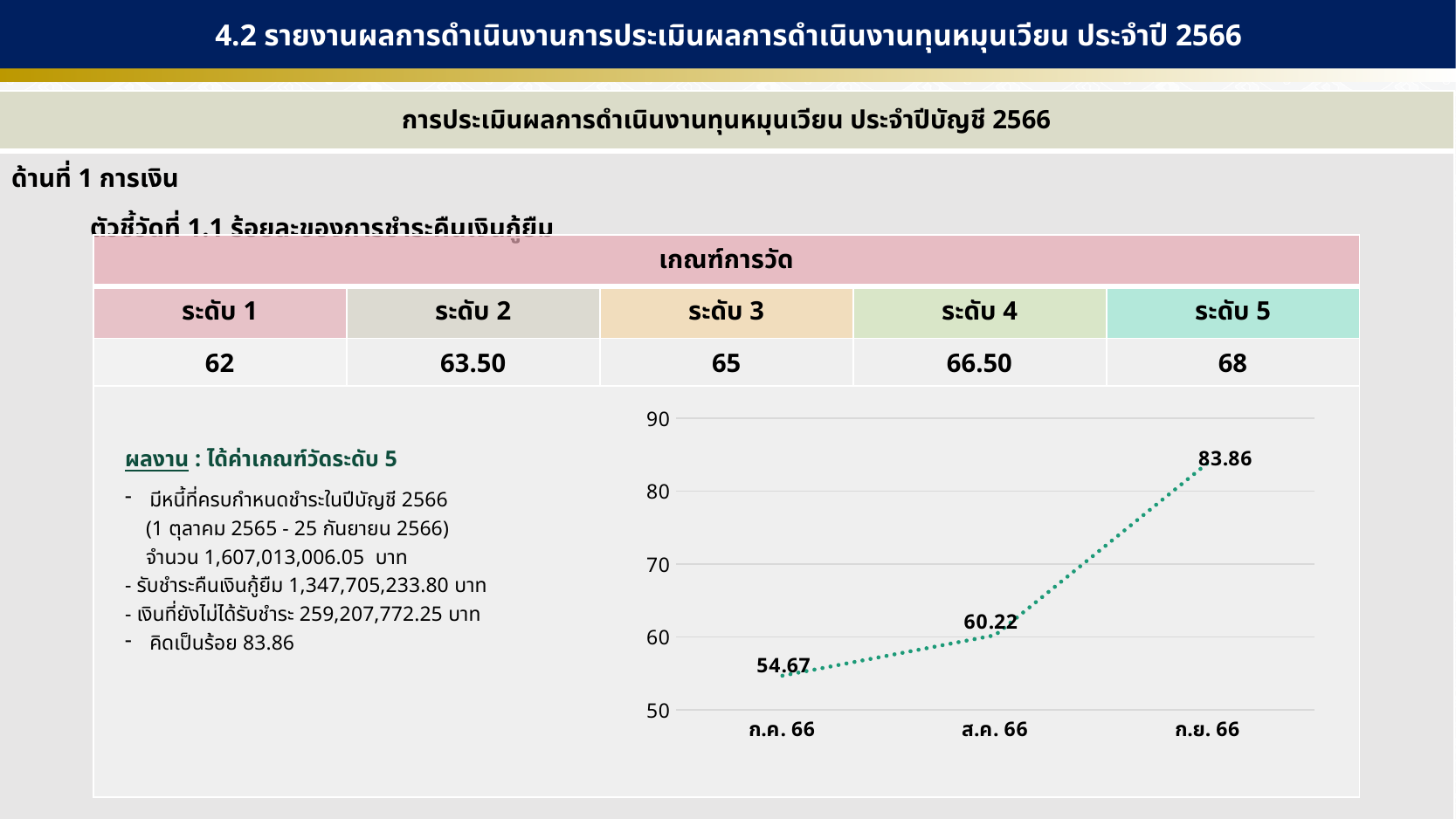
Which is larger, the value for ส.ค. 66 or the value for ก.ค. 66? ส.ค. 66 Do the values rise or fall from ก.ค. 66 to ก.ย. 66? rise Which month has the highest value on the chart? ก.ย. 66 What is the value plotted for ก.ค. 66? 54.67 What kind of chart is shown on the slide? line chart Is the value for ก.ย. 66 greater or less than 80? greater How many data points are plotted on the chart? 3 What is the difference between the values for ก.ย. 66 and ส.ค. 66? 23.64 What is the value plotted for ส.ค. 66? 60.22 Which month has the lowest value on the chart? ก.ค. 66 What is the value plotted for ก.ย. 66? 83.86 What is the difference between the values for ส.ค. 66 and ก.ค. 66? 5.55